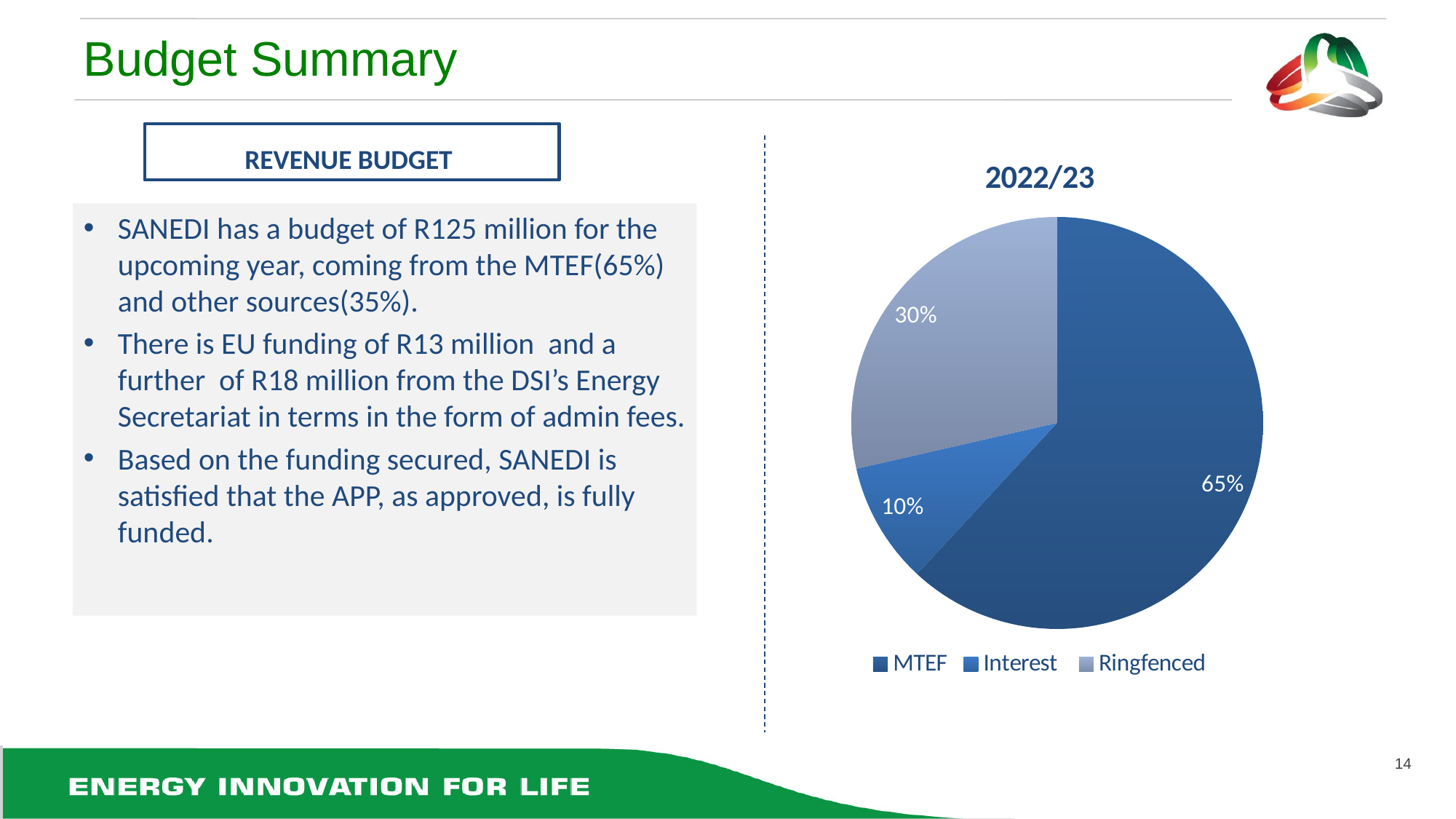
What share of the 2022/23 pie chart is MTEF? 65% In the 2022/23 pie chart, what is the difference in percentage points between the MTEF and Ringfenced slices? 35 What is the title of the pie chart? 2022/23 What share of the 2022/23 pie chart is Interest? 10% In the 2022/23 pie chart, which is larger: the Interest slice or the Ringfenced slice? Ringfenced How many categories are shown in the 2022/23 pie chart? 3 In the 2022/23 pie chart, what is the difference in percentage points between the Ringfenced and Interest slices? 20 What are the legend entries of the pie chart? MTEF, Interest, Ringfenced What share of the 2022/23 pie chart is Ringfenced? 30% What type of chart is shown on the slide? Pie chart Which category has the smallest slice in the 2022/23 pie chart? Interest Which category has the largest slice in the 2022/23 pie chart? MTEF